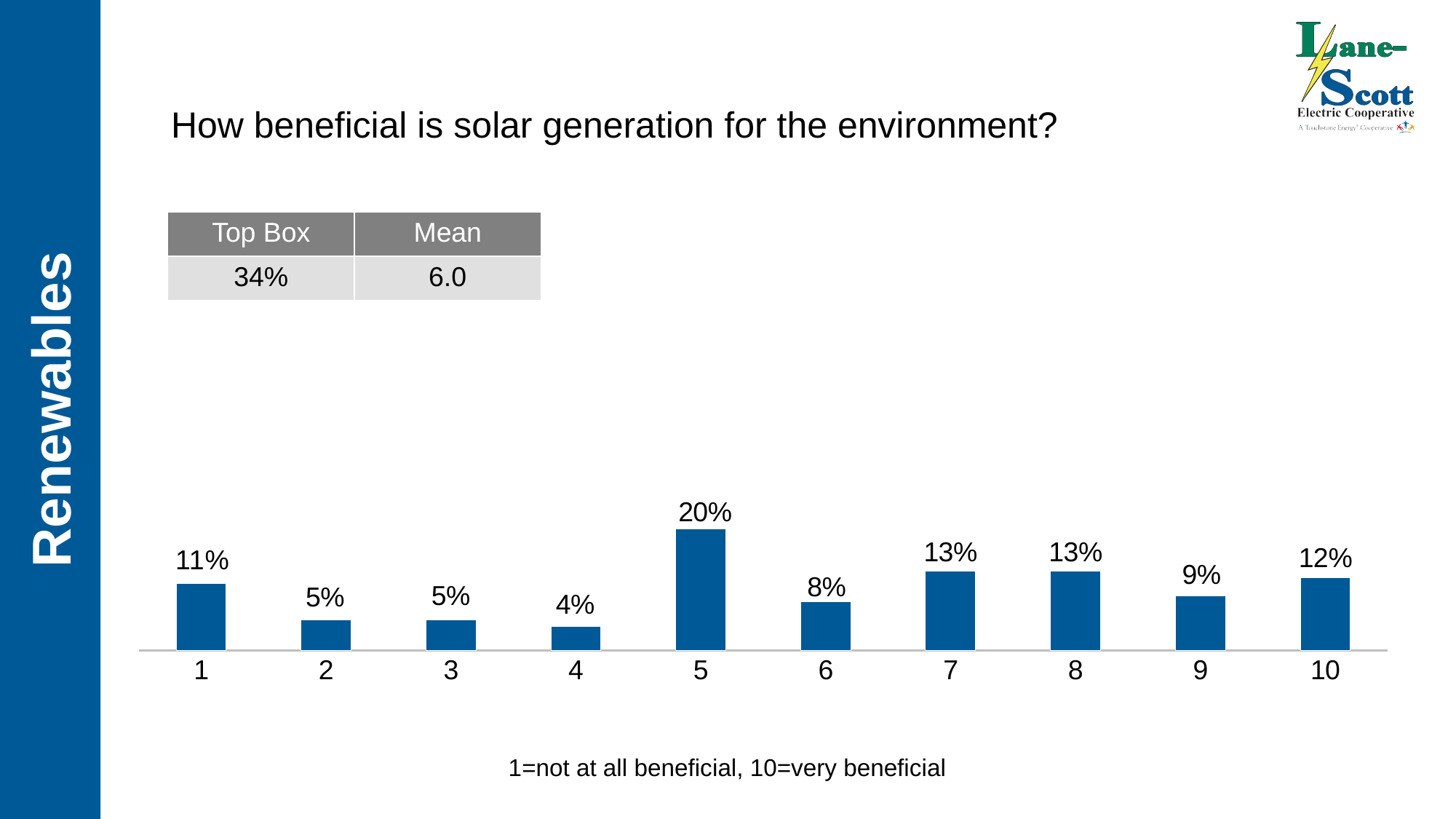
How many rating categories are shown on the x axis? 10 What percentage of respondents gave a rating of 5? 20% What percentage of respondents gave a rating of 1? 11% Which has a larger percentage, rating 9 or rating 10? 10 What percentage of respondents gave a rating of 10? 12% Which rating received the highest percentage of responses? 5 What kind of chart is shown on the slide? bar chart What is the difference in percentage points between rating 5 and rating 6? 12 What is the combined percentage for ratings 7 and 8? 26% What is the Mean value shown in the table? 6.0 Which rating received the lowest percentage of responses? 4 What is the Top Box value shown in the table? 34%